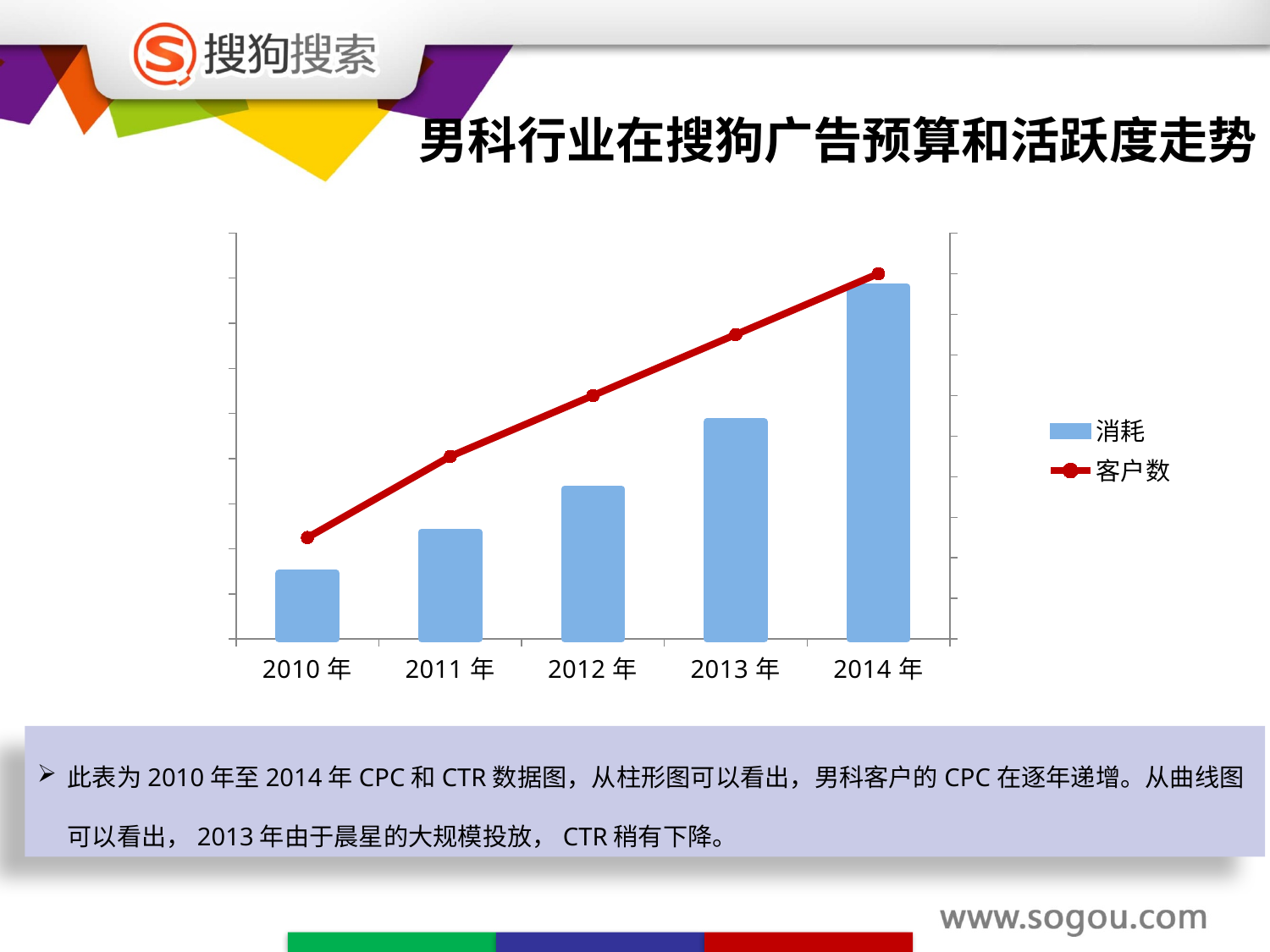
How many series does the chart legend list? 2 What kind of chart is used for the 客户数 series? line chart How many categories are shown on the x axis of the chart? 5 What kind of chart is used for the 消耗 series? bar chart Which year has the highest 消耗 bar? 2014 年 Is the 消耗 bar for 2013 年 taller or shorter than the bar for 2012 年? taller Which year has the lowest 客户数 point? 2010 年 Which year has the highest 客户数 point? 2014 年 Do the 消耗 bars rise or fall from 2010 年 to 2014 年? rise What colour are the 消耗 bars in the chart? light blue Does the 客户数 line rise or fall from 2010 年 to 2014 年? rise Which year has the lowest 消耗 bar? 2010 年